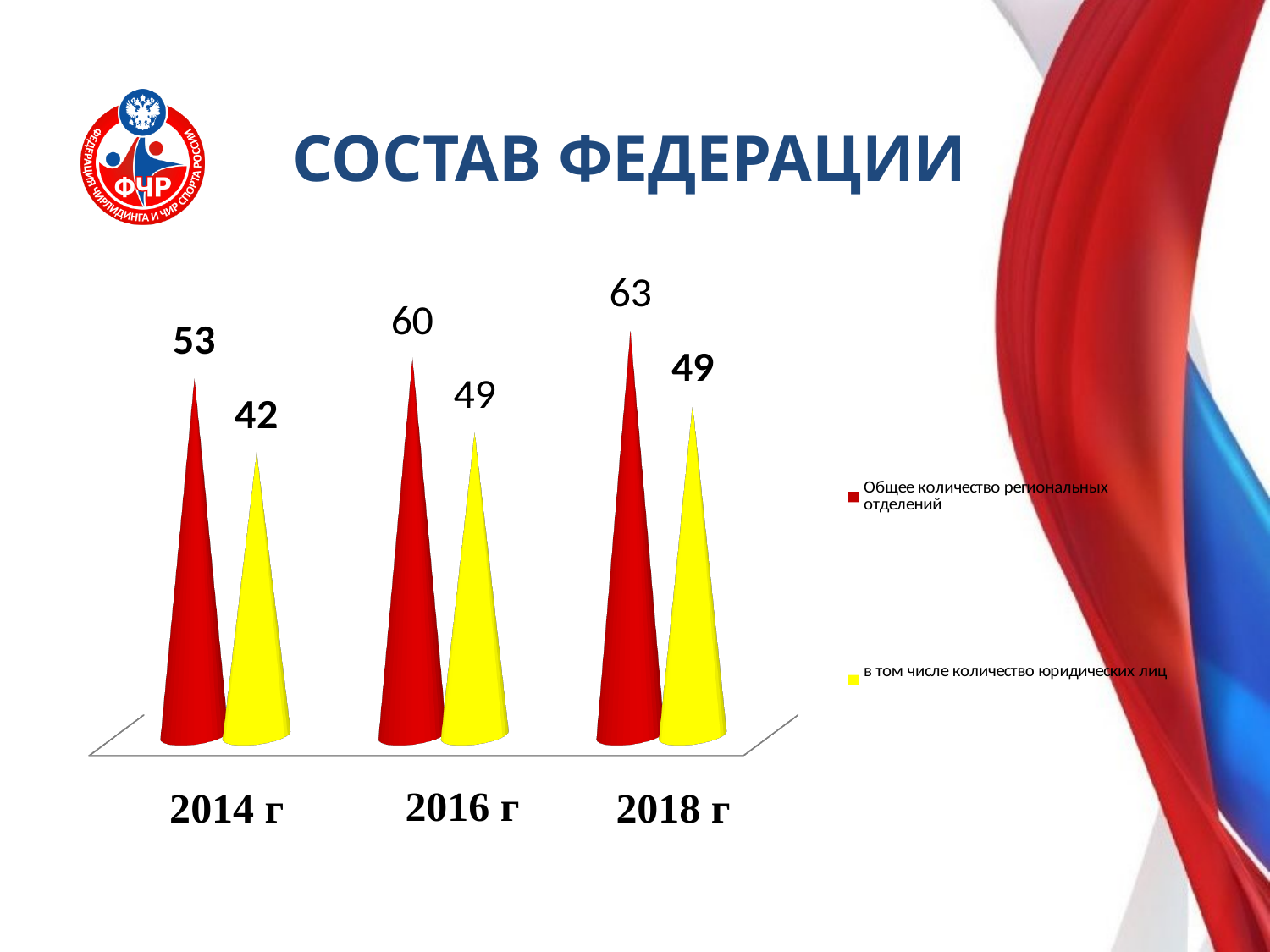
How many series does the legend list? 2 What is the value of 'Общее количество региональных отделений' for 2018 г? 63 What is the difference between 'Общее количество региональных отделений' and 'в том числе количество юридических лиц' in 2018 г? 14 Does 'Общее количество региональных отделений' rise or fall from 2014 г to 2018 г? Rise What is the value of 'в том числе количество юридических лиц' for 2016 г? 49 What kind of chart is shown on the slide? Bar chart How many years are shown on the x axis of the chart? 3 In which year is 'Общее количество региональных отделений' highest? 2018 г Which is larger in 2016 г: 'Общее количество региональных отделений' or 'в том числе количество юридических лиц'? Общее количество региональных отделений What is the value of 'в том числе количество юридических лиц' for 2014 г? 42 What is the value of 'Общее количество региональных отделений' for 2014 г? 53 In which year is 'в том числе количество юридических лиц' lowest? 2014 г